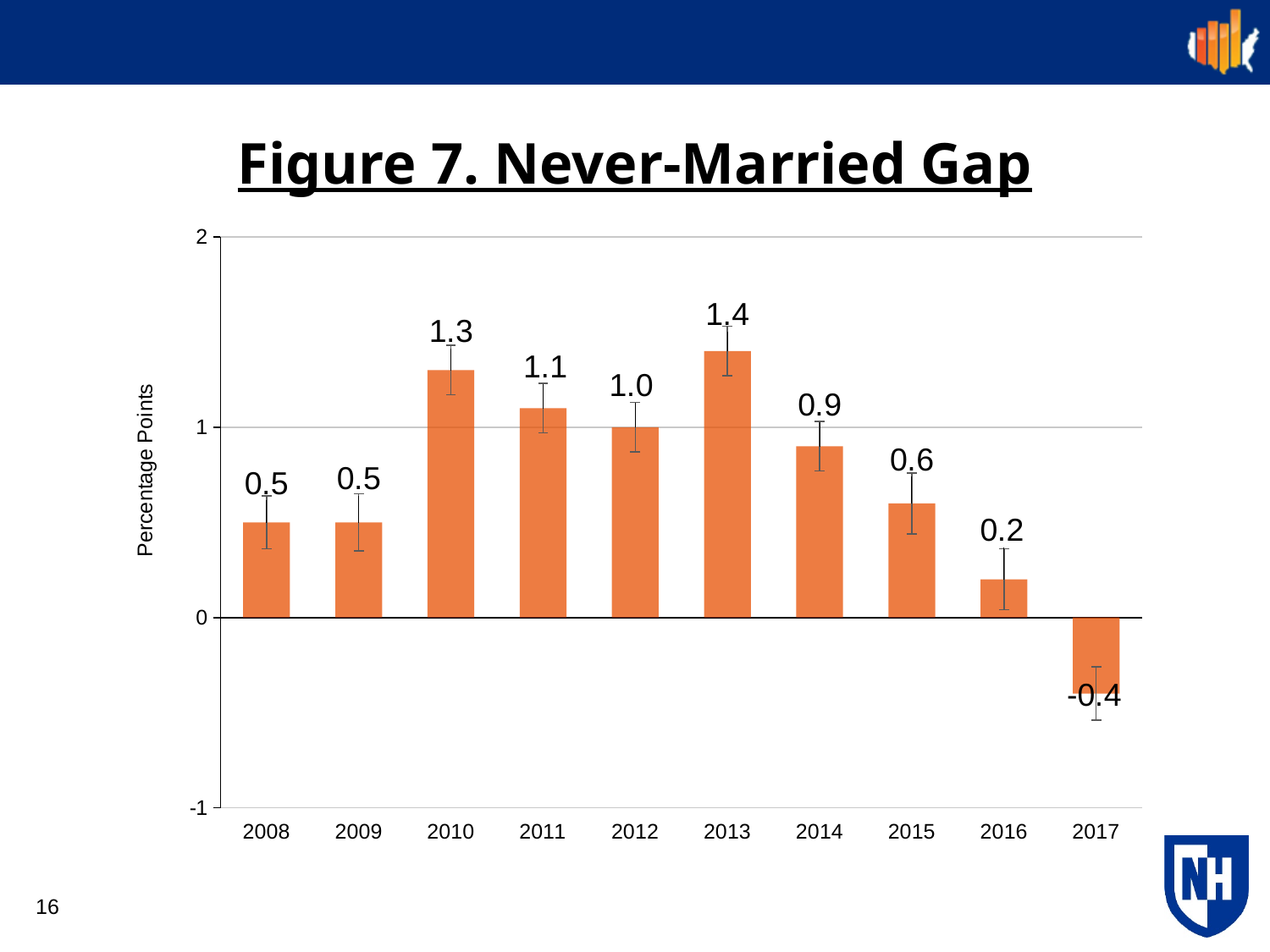
What is the difference between the values for 2013 and 2016? 1.2 Which year has the lowest never-married gap? 2017 What is the value shown for 2017? -0.4 What is the value shown for 2010? 1.3 Is the value for 2012 greater or less than 0? greater Do the values rise or fall from 2013 to 2017? Fall Which year has a larger value, 2011 or 2014? 2011 What is the never-married gap value for 2013? 1.4 Which year has the highest never-married gap? 2013 How many years are shown on the x axis? 10 What is the label on the vertical axis? Percentage Points What kind of chart is shown on the slide? Bar chart